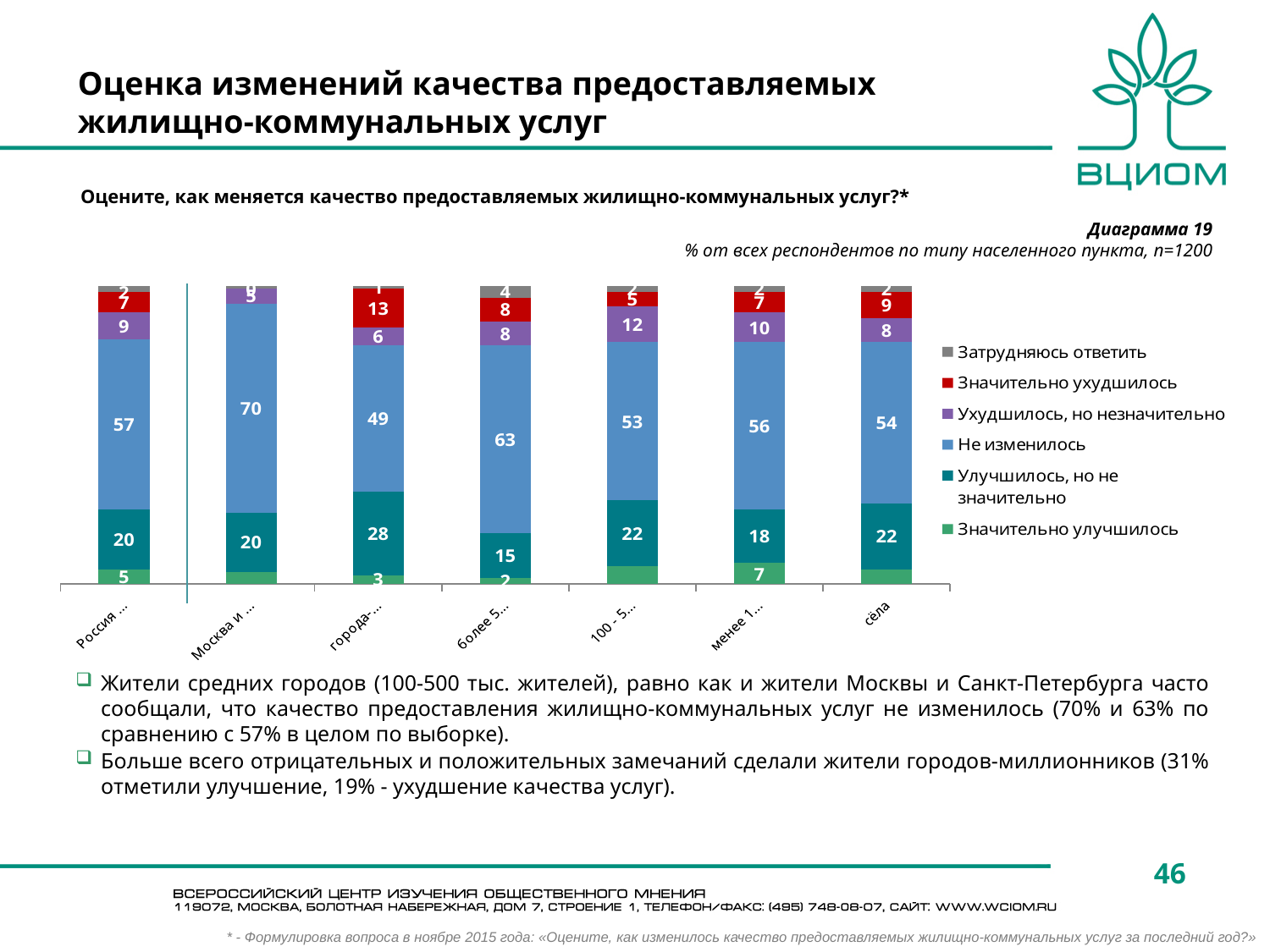
What is the value of 'Не изменилось' for the 'сёла' category? 54 What kind of chart is shown on the slide? stacked bar chart What is the value of 'Затрудняюсь ответить' for the 'сёла' category? 2 How many categories (bars) are plotted on the chart? 7 What is the value of 'Улучшилось, но не значительно' for the 'сёла' category? 22 How many series does the chart legend list? 6 What is the value of 'Ухудшилось, но незначительно' for the 'сёла' category? 8 What is the value of 'Значительно ухудшилось' for the 'сёла' category? 9 What is the difference between the 'Не изменилось' value of the first bar (Россия ...) and that of 'сёла'? 3 Which colour represents 'Не изменилось' in the legend? blue Which bar has the highest value for 'Не изменилось'? the second bar (Москва и ...), 70 Which bar has the lowest value for 'Не изменилось'? the third bar (города-...), 49